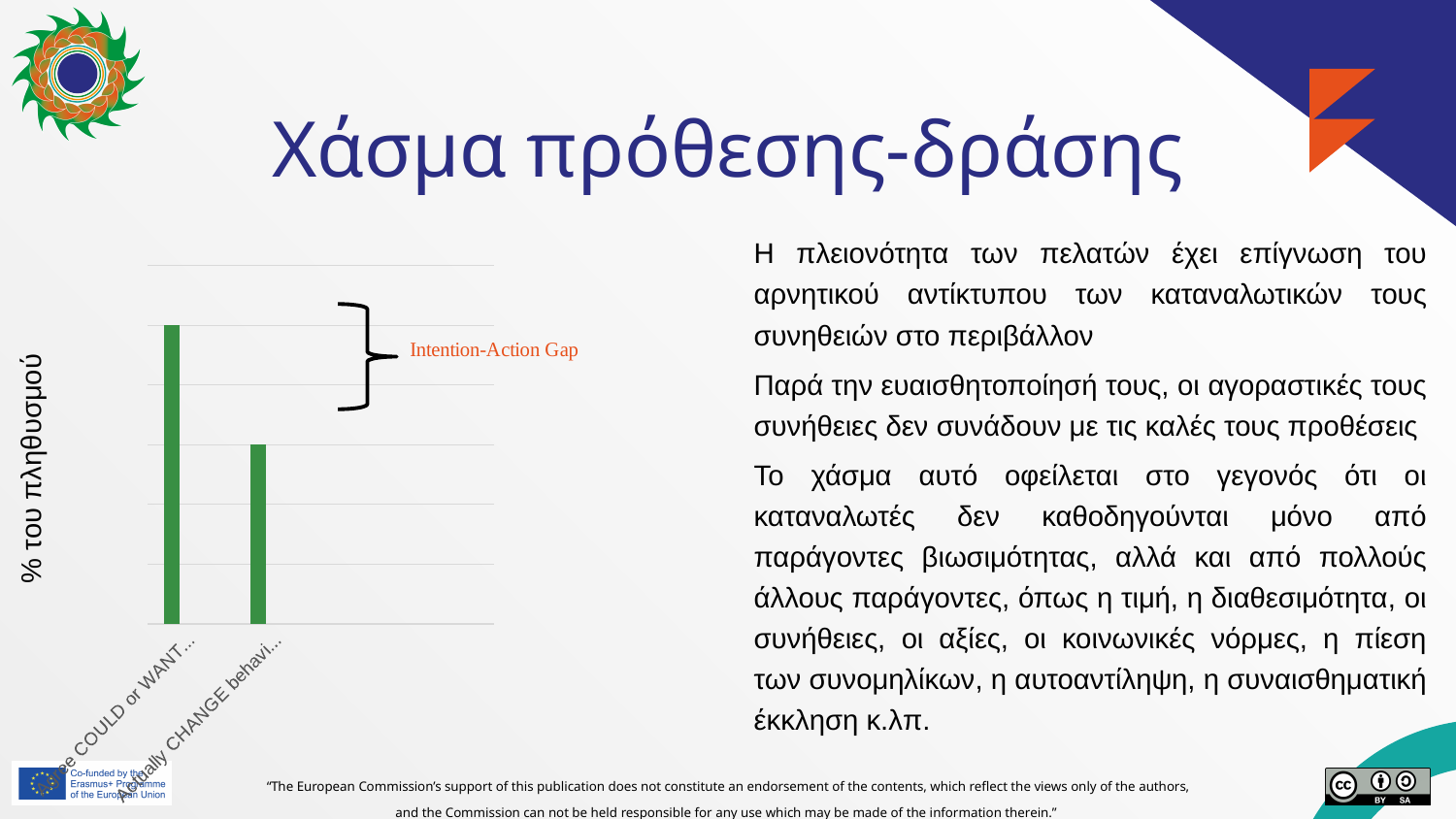
Which bar in the chart has the highest value? the left bar What kind of chart is shown on the left of the slide? bar chart Which bar is taller, the left bar or the right bar? the left bar Do the bar values rise or fall from left to right? fall Which bar in the chart has the lowest value? the right bar What is the label on the vertical axis of the chart? % του πληθυσμού How many bars does the chart show? 2 What label is written next to the bracket above the bars? Intention-Action Gap